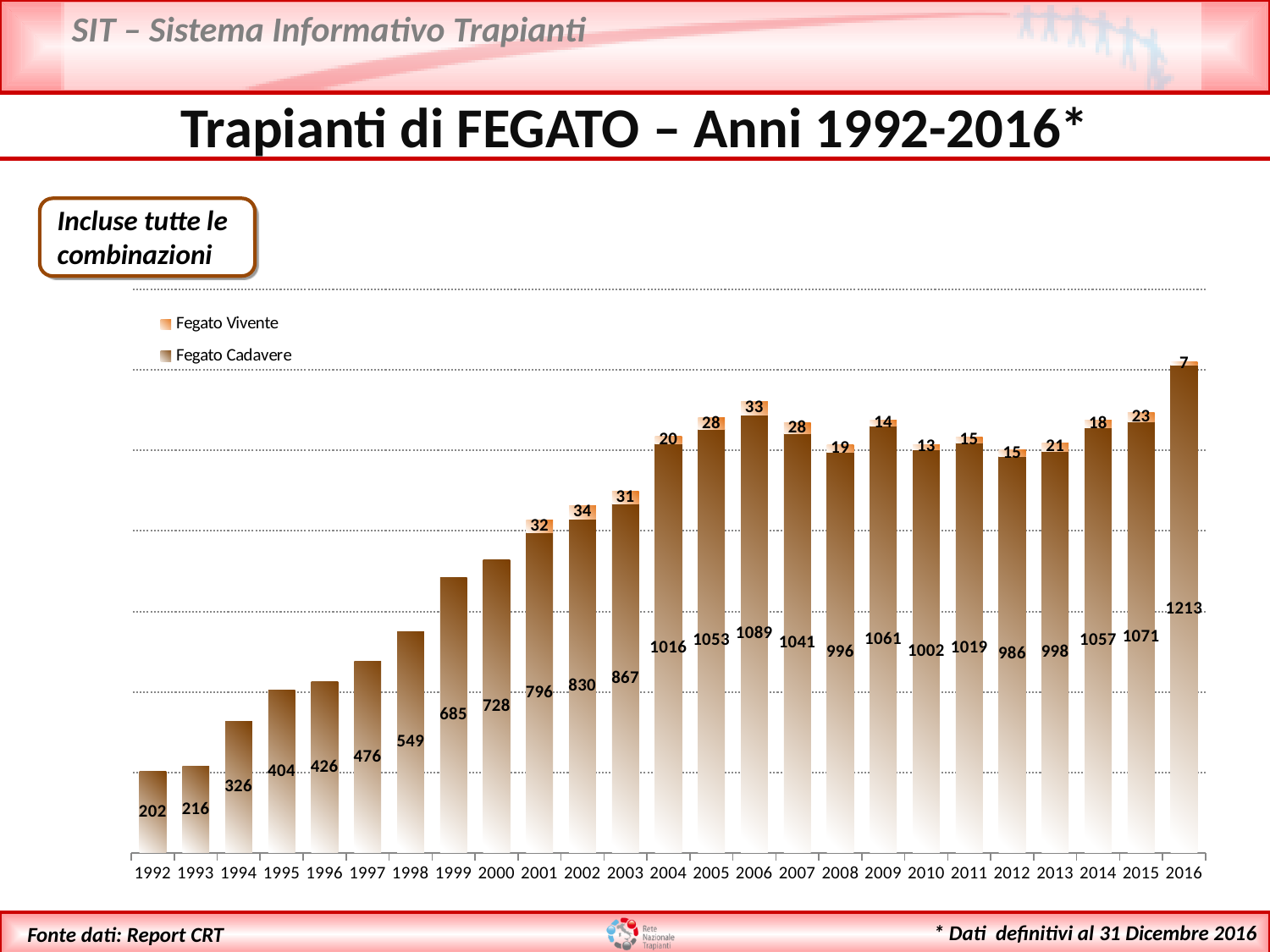
How many series does the legend list? 2 What is the Fegato Cadavere value for 2016? 1213 What is the Fegato Cadavere value for 1992? 202 What is the total of the stacked bar for 2016 (Fegato Cadavere plus Fegato Vivente)? 1220 How many years are shown on the x axis? 25 Which year has the lowest Fegato Cadavere value? 1992 Which is larger, the Fegato Cadavere value for 2006 or for 2009? 2006 Do the Fegato Cadavere values generally rise or fall from 1992 to 2006? rise Which year has the highest Fegato Cadavere value? 2016 What is the Fegato Vivente value for 2006? 33 What type of chart is shown on the slide? bar chart What is the difference between the Fegato Cadavere values for 2016 and 2015? 142